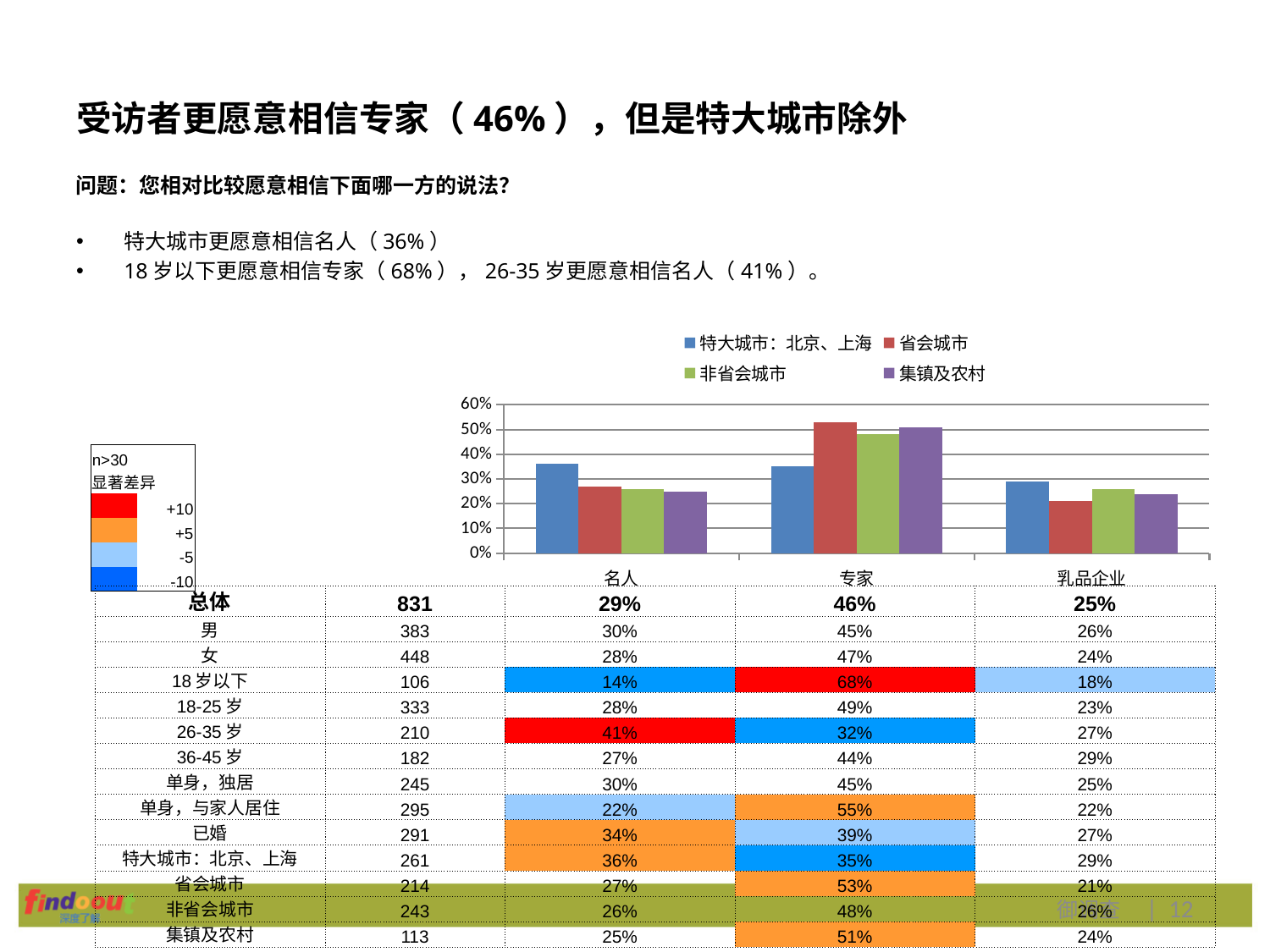
For the 乳品企业 category, which series has the lowest bar? 省会城市 How many series does the chart legend list? 4 According to the table, what is the value for 集镇及农村 in the 专家 category? 51% According to the table, what is the value for 特大城市：北京、上海 in the 名人 category? 36% Is the value for 省会城市 in the 专家 category greater or less than 40%? greater How many categories are shown along the x axis of the chart? 3 What kind of chart is shown on the slide? bar chart What colour represents 集镇及农村 in the chart legend? purple For the 名人 category, which series has the highest bar? 特大城市：北京、上海 In the 名人 category, which is larger: the bar for 特大城市：北京、上海 or the bar for 省会城市? 特大城市：北京、上海 Using the table values, what is the difference between 特大城市：北京、上海 (36%) and 省会城市 (27%) in the 名人 category? 9 percentage points Is the value for 特大城市：北京、上海 in the 专家 category greater or less than 40%? less